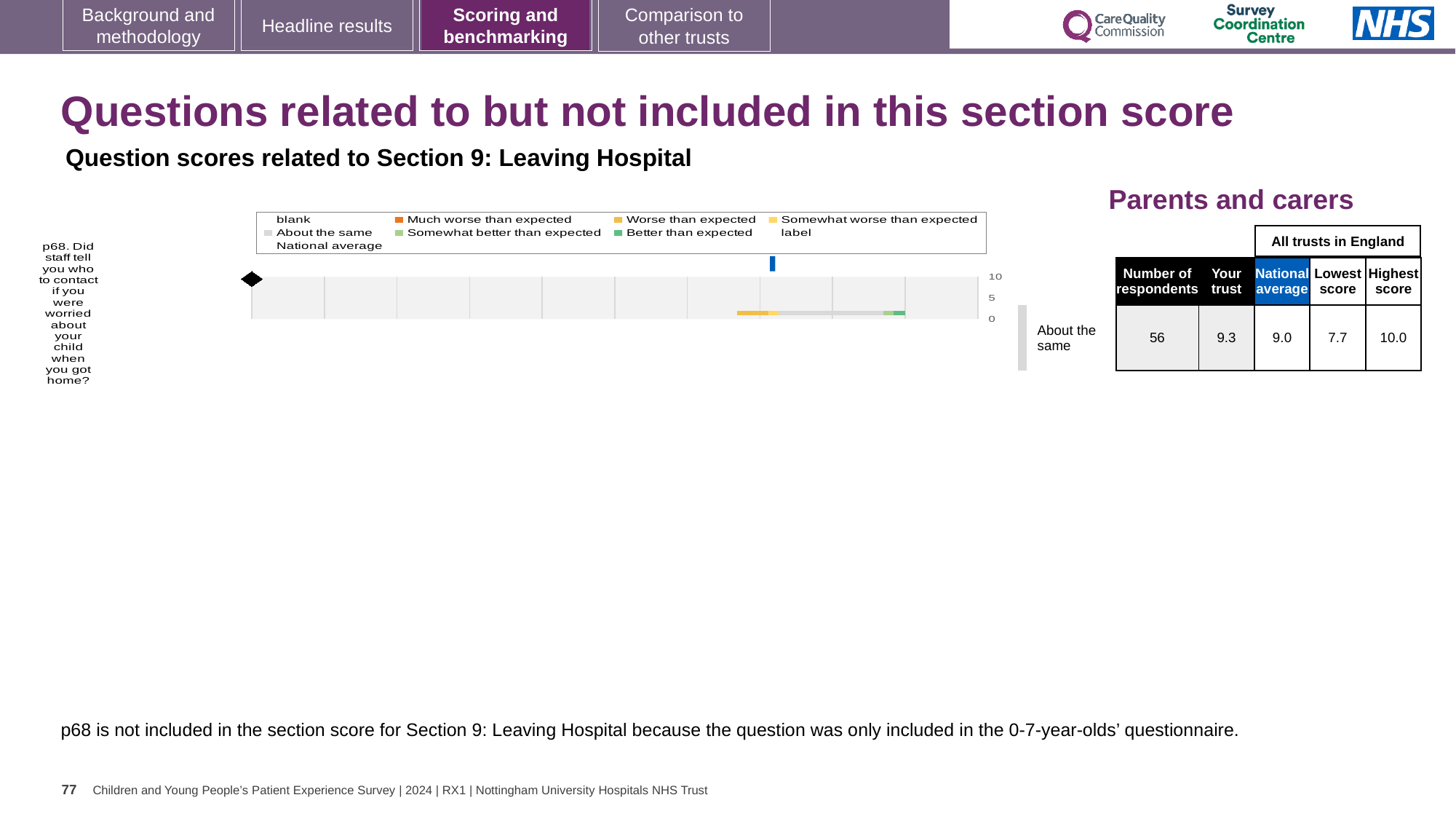
According to the table beside the chart, what is the lowest score among all trusts in England for p68? 7.7 For p68, which is larger: the "Your trust" score or the national average? Your trust Which colour does the legend use for "Better than expected"? green According to the table beside the chart, how many respondents answered p68? 56 What kind of chart is shown for question p68? bar chart For p68, what is the difference between the highest score and the lowest score among all trusts in England? 2.3 According to the table beside the chart, what is the national average score for p68? 9.0 According to the table beside the chart, what is the "Your trust" score for p68? 9.3 How many survey questions are plotted in the chart? 1 According to the table beside the chart, what is the highest score among all trusts in England for p68? 10.0 What rating category label is shown to the right of the p68 bar? About the same